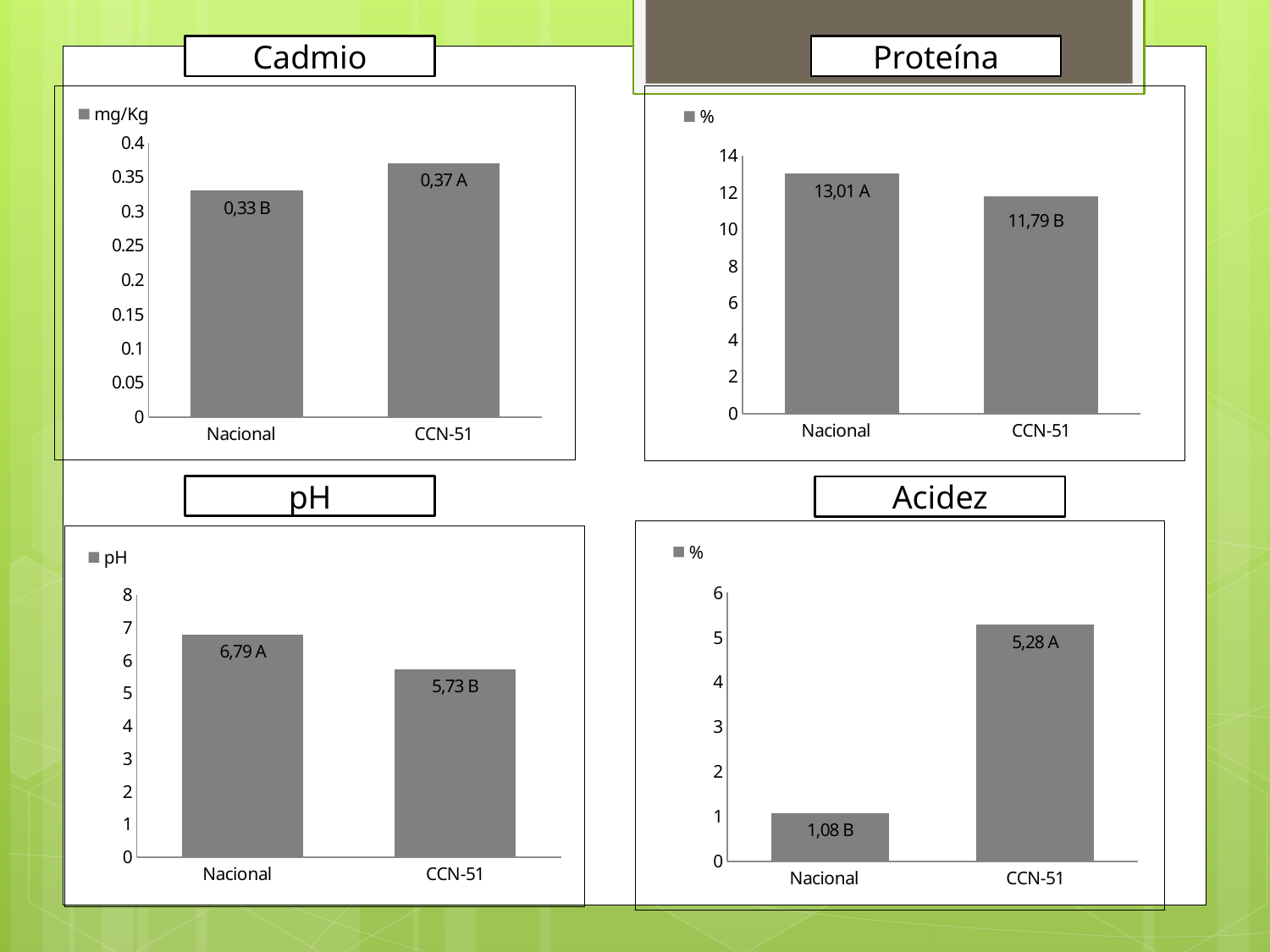
In the pH chart, what is the data label for Nacional? 6,79 A What kind of chart is the pH chart? bar chart In the Cadmio chart, which category has the higher value? CCN-51 In the Proteína chart, what is the difference between the Nacional and CCN-51 values? 1,22 How many categories are shown on the x axis of the Proteína chart? 2 In the Cadmio chart, what is the data label for Nacional? 0,33 B In the Proteína chart, what is the data label for CCN-51? 11,79 B In the pH chart, which category has the lower value? CCN-51 In the Acidez chart, which is larger, the value for Nacional or the value for CCN-51? CCN-51 In the Acidez chart, is the value for Nacional greater or less than 2? less In the Acidez chart, what is the data label for CCN-51? 5,28 A What legend entry is shown in the Cadmio chart? mg/Kg